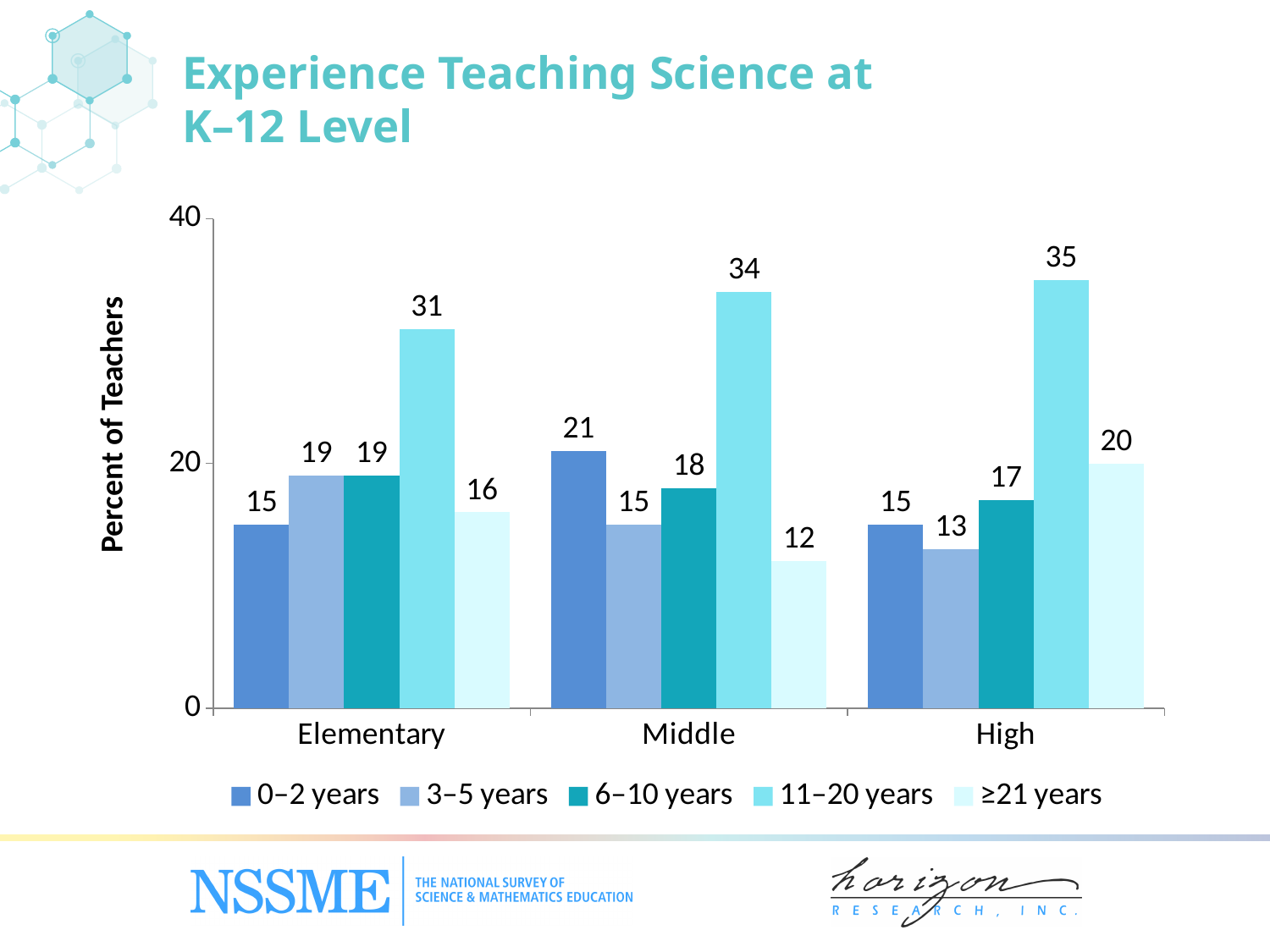
How many school levels are shown on the x axis? 3 What is the value for ≥21 years at the High level? 20 What is the difference between the 11–20 years value for High and the 11–20 years value for Elementary? 4 Which experience category has the lowest value at the Middle level? ≥21 years Which is larger: the 3–5 years value for Elementary or the 3–5 years value for High? Elementary What is the label of the y axis? Percent of Teachers Is the value for 6–10 years at the Middle level greater or less than 20? less What percent of Middle school teachers have 11–20 years of experience? 34 What kind of chart is shown on the slide? bar chart What is the value for 0–2 years at the Elementary level? 15 Which experience category has the highest value at the High level? 11–20 years How many series does the legend list? 5